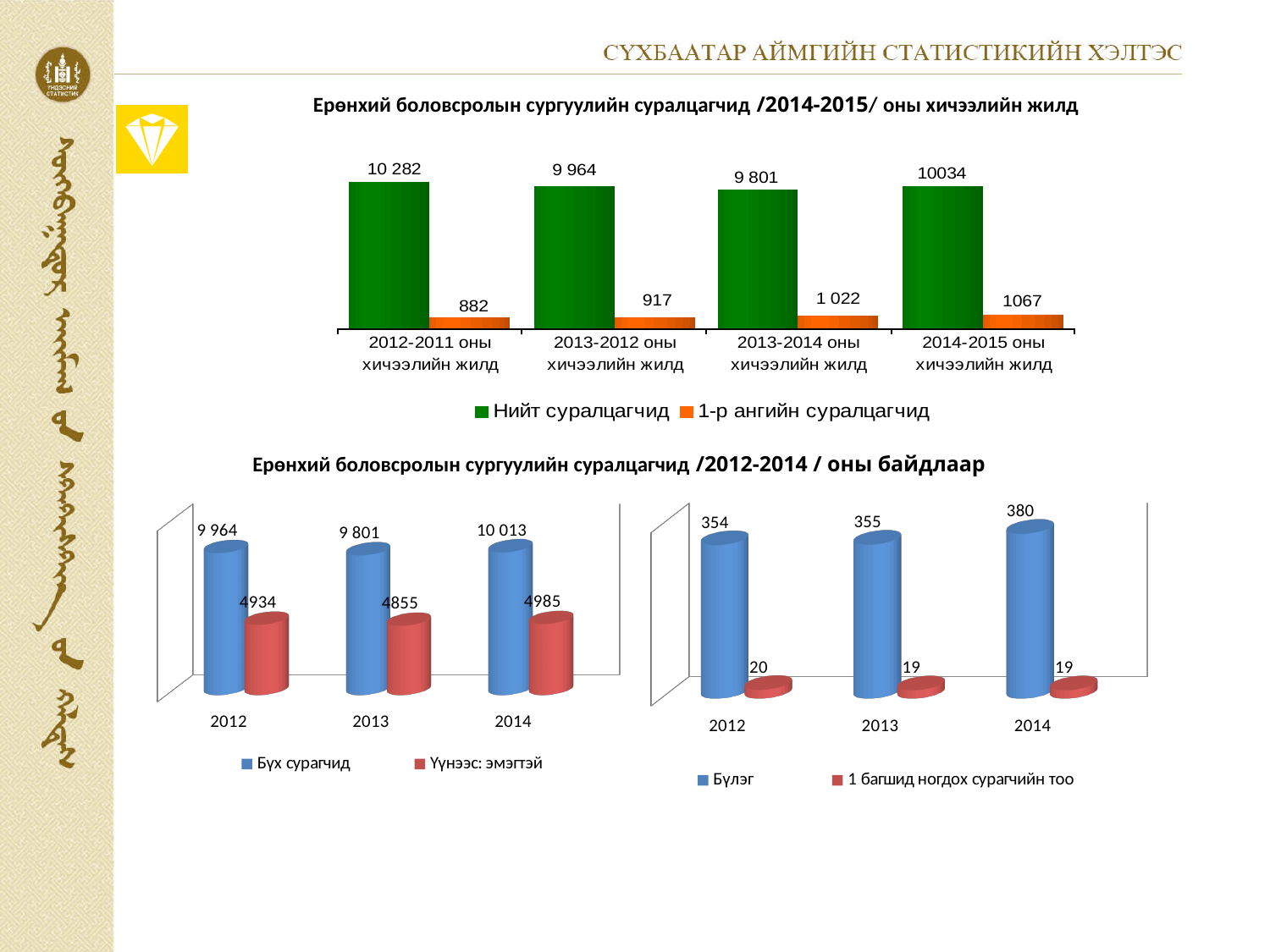
In the bottom-left chart, what is the value of Үүнээс: эмэгтэй for 2013? 4855 In the top chart, what is the value of 1-р ангийн суралцагчид for 2014-2015 оны хичээлийн жилд? 1067 In the bottom-left chart, how many years are shown on the x axis? 3 In the top chart, how many series does the legend list? 2 In the top chart, what is the value of Нийт суралцагчид for 2012-2011 оны хичээлийн жилд? 10 282 In the top chart, which school year has the lowest value for Нийт суралцагчид? 2013-2014 оны хичээлийн жилд In the bottom-right chart, what is the difference between the Бүлэг values for 2014 and 2013? 25 In the bottom-right chart, what is the value of Бүлэг for 2014? 380 In the bottom-left chart, which year has the highest value for Бүх сурагчид? 2014 In the top chart, what is the difference between the 1-р ангийн суралцагчид values for 2013-2012 and 2012-2011? 35 What kind of chart is the bottom-right chart? Bar chart In the top chart, which school year has the highest value for 1-р ангийн суралцагчид? 2014-2015 оны хичээлийн жилд